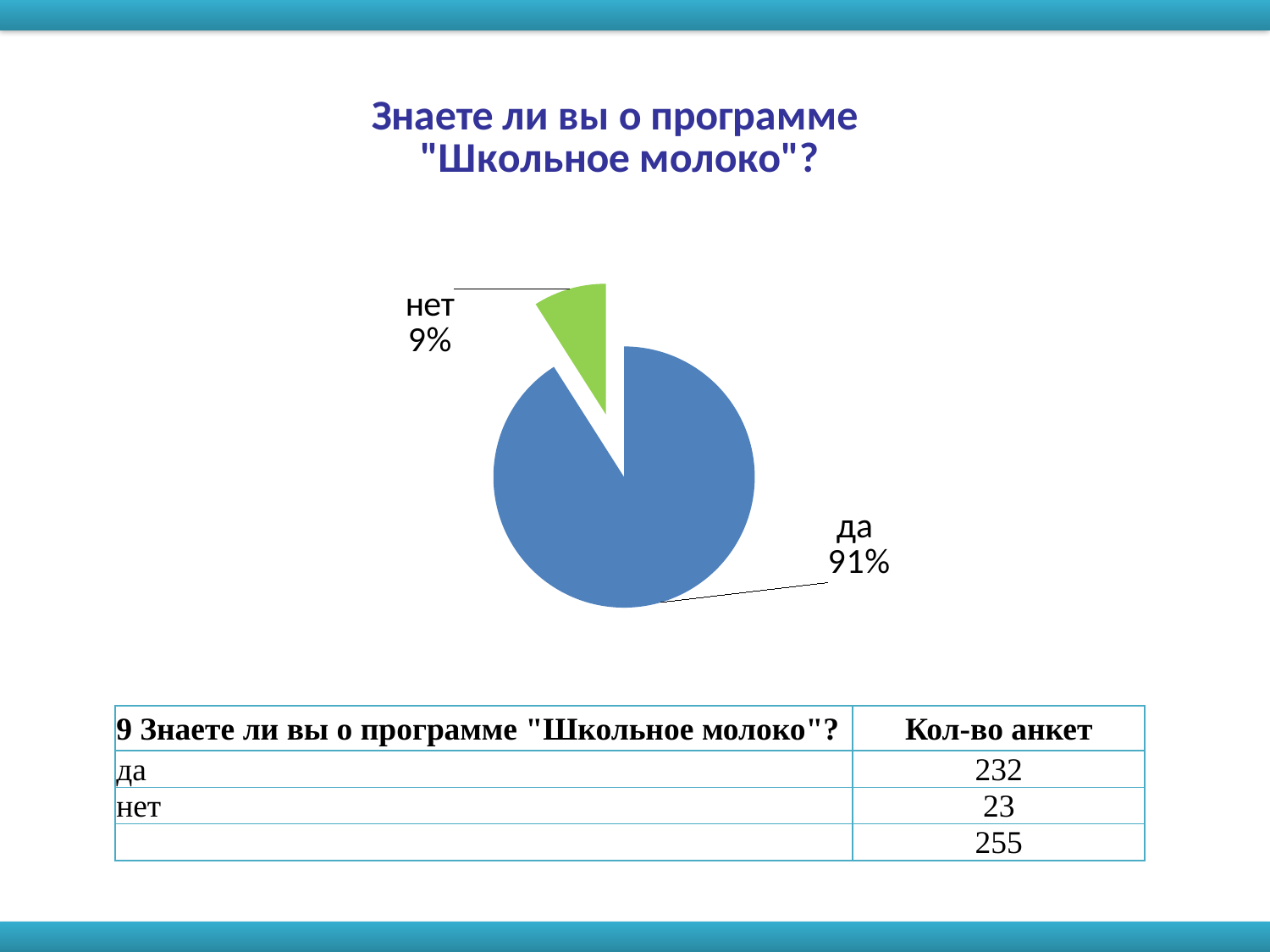
Which is larger, the "да" slice or the "нет" slice? да What share of the pie does the "да" slice represent? 91% What kind of chart is shown on the slide? pie chart What colour is the "нет" slice of the pie? green What is the difference in percentage points between the "да" and "нет" slices? 82 Which slice of the pie is the largest? да What share of the pie does the "нет" slice represent? 9% Which slice of the pie is the smallest? нет How many slices does the pie chart have? 2 What is the title of the chart? Знаете ли вы о программе "Школьное молоко"?